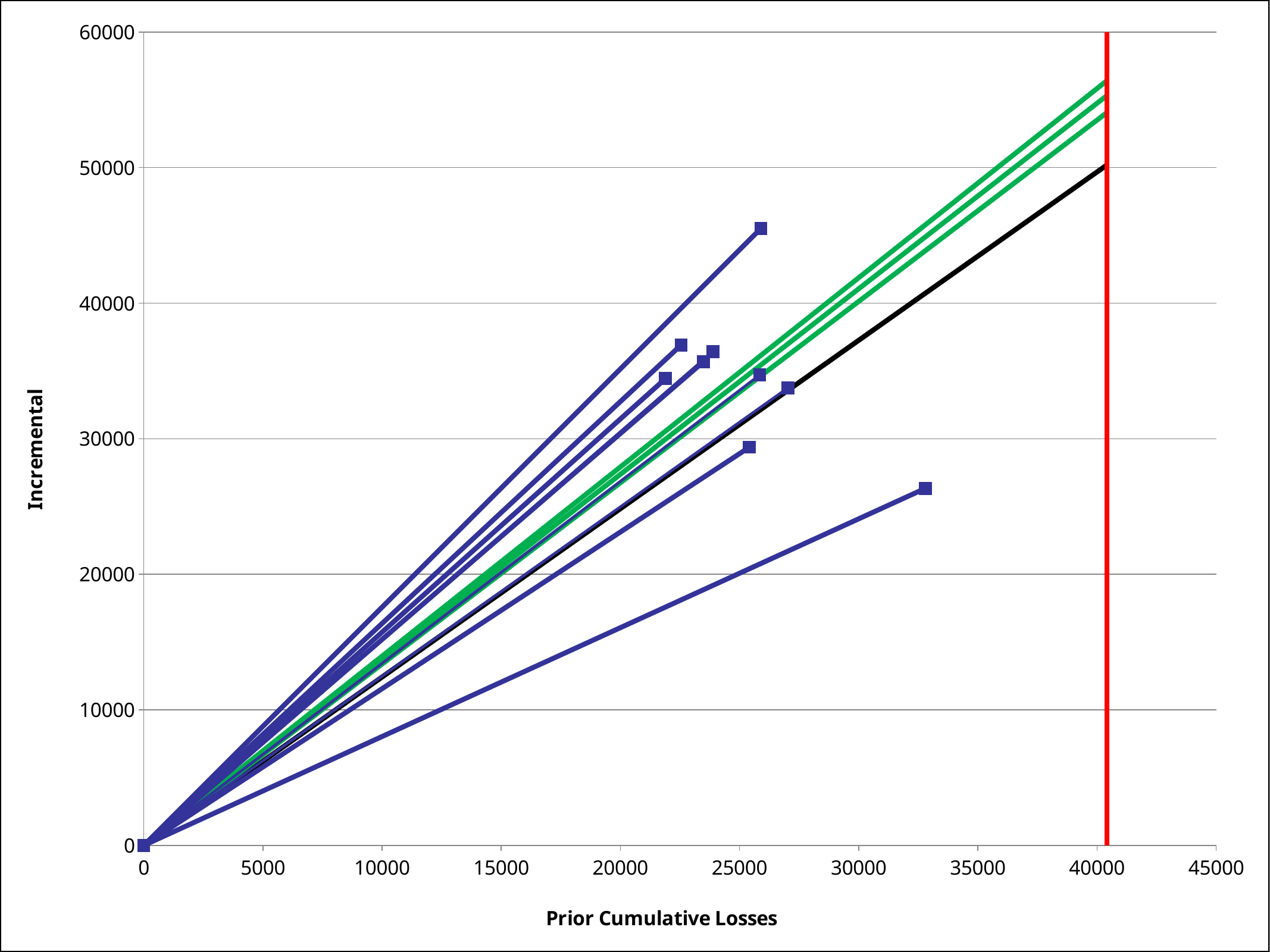
Is the Incremental value of the lowest blue marker greater or less than 30000? less How many green lines are drawn on the chart? 3 Which has the higher Incremental value: the rightmost blue marker or the topmost blue marker? the topmost blue marker What kind of chart is shown on the slide? line chart What is the label of the x axis? Prior Cumulative Losses What is the label of the y axis? Incremental Is the Prior Cumulative Losses value of the rightmost blue marker greater or less than 30000? greater How many blue square markers are plotted away from the origin? 9 At the red vertical line, which reaches a higher Incremental value: the green lines or the black line? the green lines Is the red vertical line positioned at a Prior Cumulative Losses value greater or less than 40000? greater Do the blue lines rise or fall as Prior Cumulative Losses increases? rise